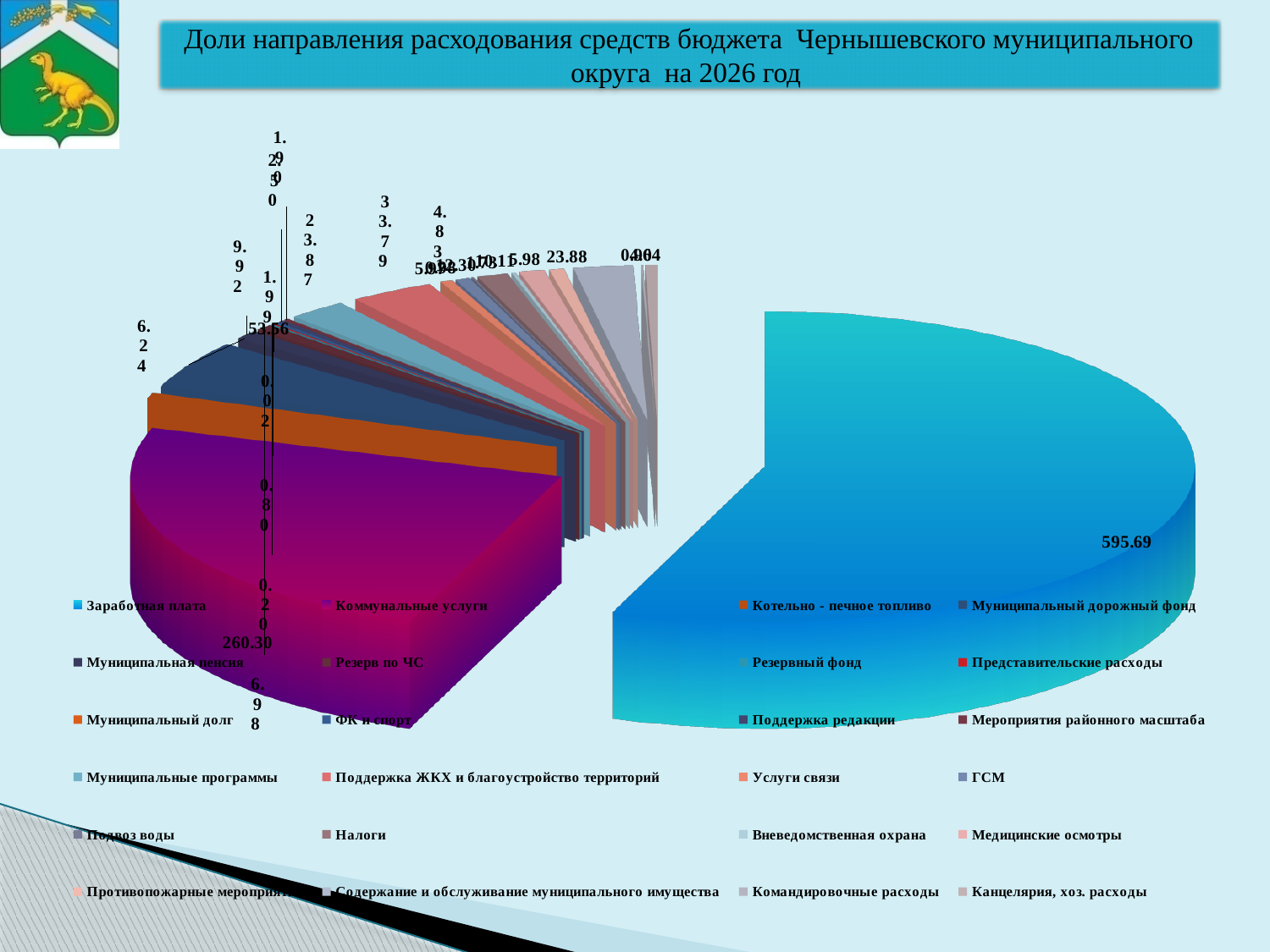
Which legend entry is shown with a blue marker, matching the largest slice? Заработная плата What kind of chart is shown on the slide? pie chart What is the value shown for Коммунальные услуги? 260.30 How many categories does the legend list? 24 What is the value shown for the largest slice (Заработная плата)? 595.69 Which is larger, Заработная плата or Коммунальные услуги? Заработная плата Which category has the largest slice of the pie? Заработная плата What is the difference between the values for Заработная плата and Коммунальные услуги? 335.39 What is the title of the chart on the slide? Доли направления расходования средств бюджета Чернышевского муниципального округа на 2026 год